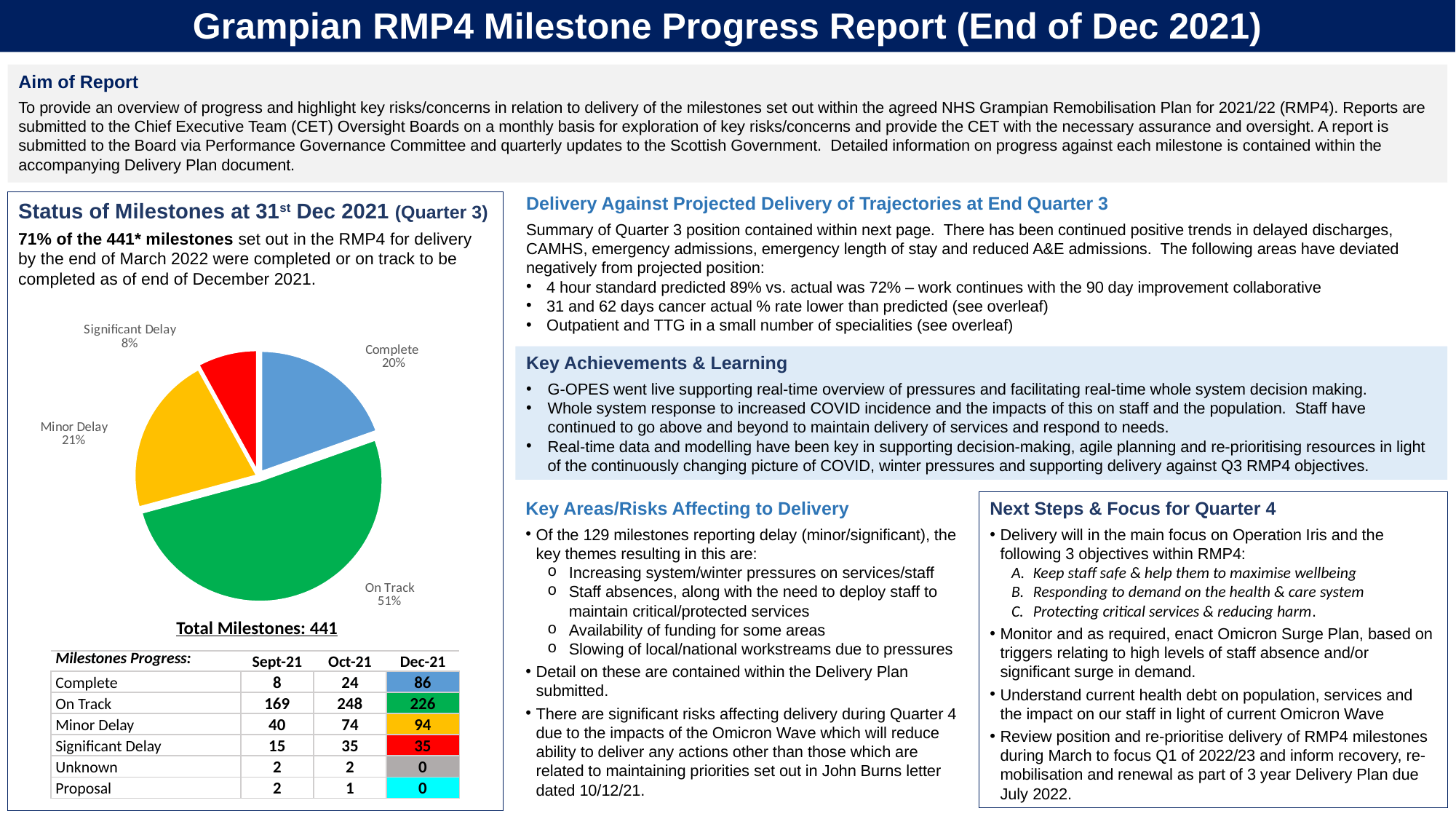
How many slices does the pie chart have? 4 What is the total number of milestones stated below the pie chart? 441 What kind of chart is shown on the slide? pie chart What share of the pie chart is labelled Complete? 20% What share of the pie chart is labelled Significant Delay? 8% Which slice is larger in the pie chart, On Track or Minor Delay? On Track What share of the pie chart is labelled On Track? 51% What is the difference in percentage points between the On Track slice and the Complete slice? 31% Which slice of the pie chart is the largest? On Track What colour is the On Track slice of the pie chart? green Which slice of the pie chart is the smallest? Significant Delay